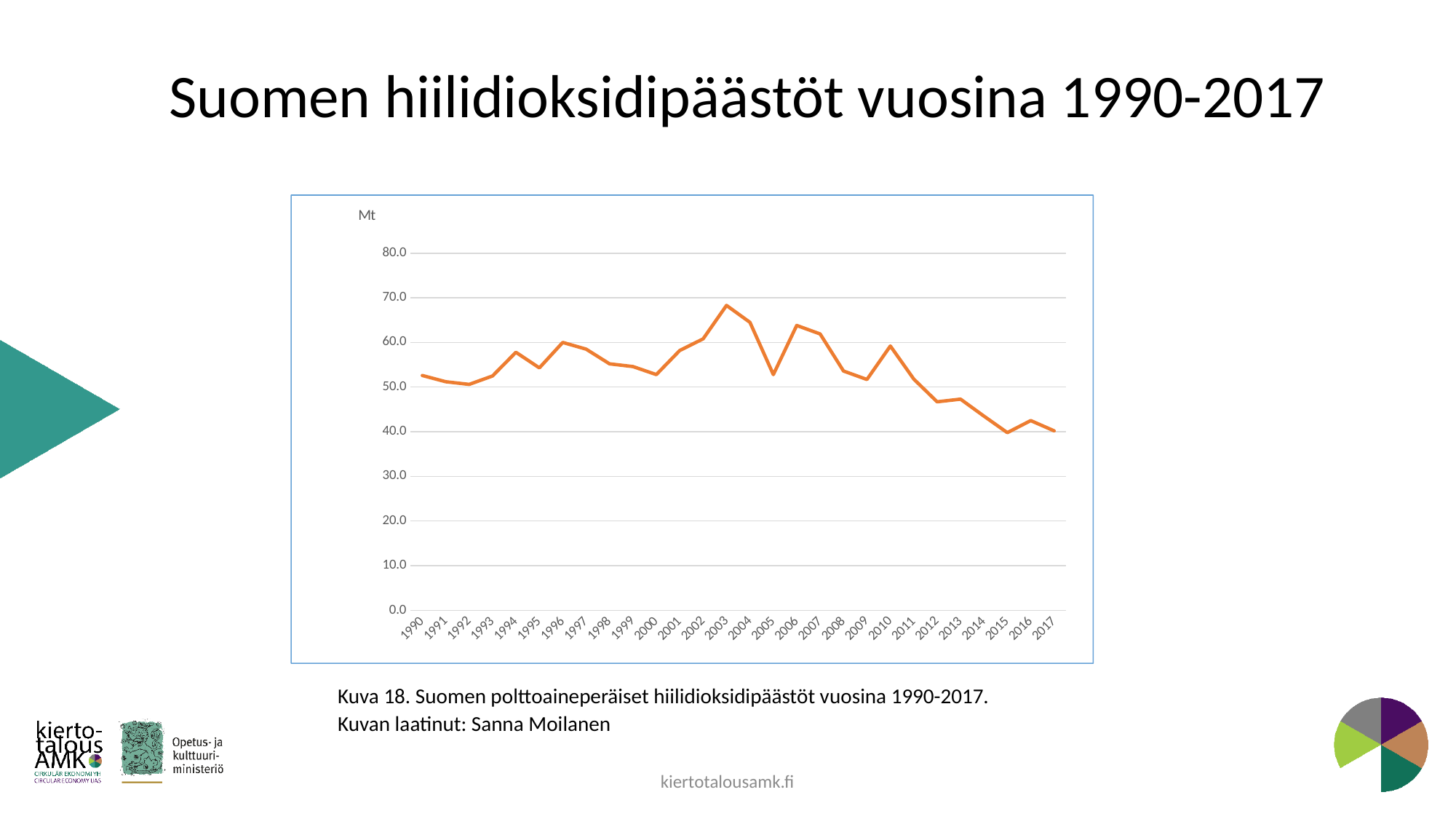
How many years (data points) are plotted on the x axis? 28 Which year has the larger value, 2003 or 2015? 2003 Which year has the larger value, 1990 or 2017? 1990 Do the emissions rise or fall from 2010 to 2015? fall Is the value for 1990 greater or less than 50? greater Is the value for 2003 greater or less than 60? greater In which year do Finland's carbon dioxide emissions reach their highest value? 2003 Is the value for 2006 greater or less than 60? greater What unit is shown on the y axis of the chart? Mt What kind of chart is shown on the slide? line chart